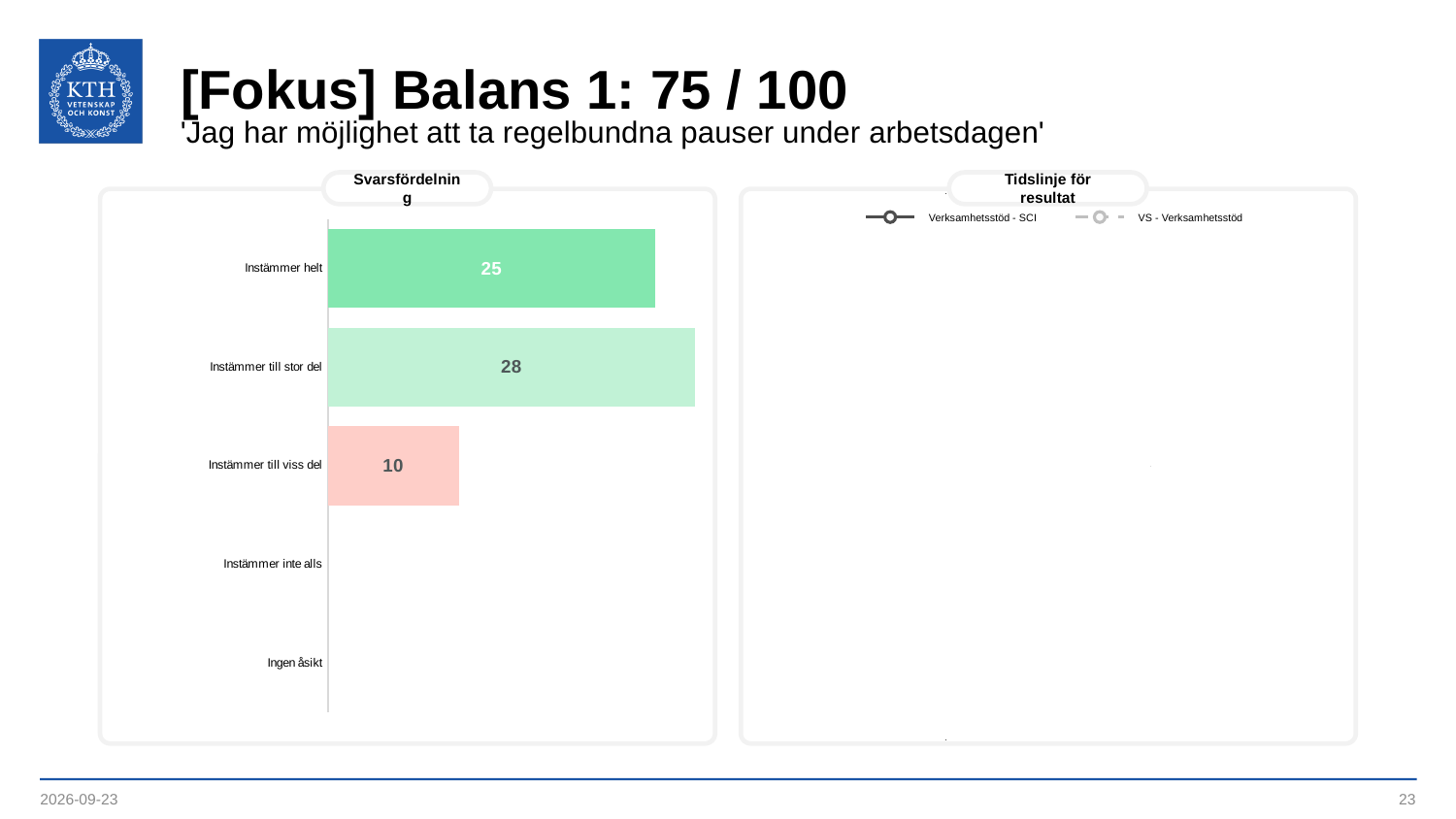
In the 'Svarsfördelning' chart, which category has the highest value? Instämmer till stor del How many series does the legend of the 'Tidslinje för resultat' chart list? 2 In the 'Svarsfördelning' chart, what is the difference between 'Instämmer helt' and 'Instämmer till viss del'? 15 In the 'Svarsfördelning' chart, what is the value for 'Instämmer till viss del'? 10 What kind of chart is the 'Svarsfördelning' chart? Bar chart In the 'Svarsfördelning' chart, which is larger: 'Instämmer helt' or 'Instämmer till viss del'? Instämmer helt In the 'Svarsfördelning' chart, what is the difference between 'Instämmer till stor del' and 'Instämmer helt'? 3 In the 'Svarsfördelning' chart, what is the value for 'Instämmer till stor del'? 28 How many categories are listed on the axis of the 'Svarsfördelning' chart? 5 In the 'Svarsfördelning' chart, which of the three labelled bars has the lowest value? Instämmer till viss del In the 'Svarsfördelning' chart, what is the value for 'Instämmer helt'? 25 What are the legend entries of the 'Tidslinje för resultat' chart? Verksamhetsstöd - SCI and VS - Verksamhetsstöd